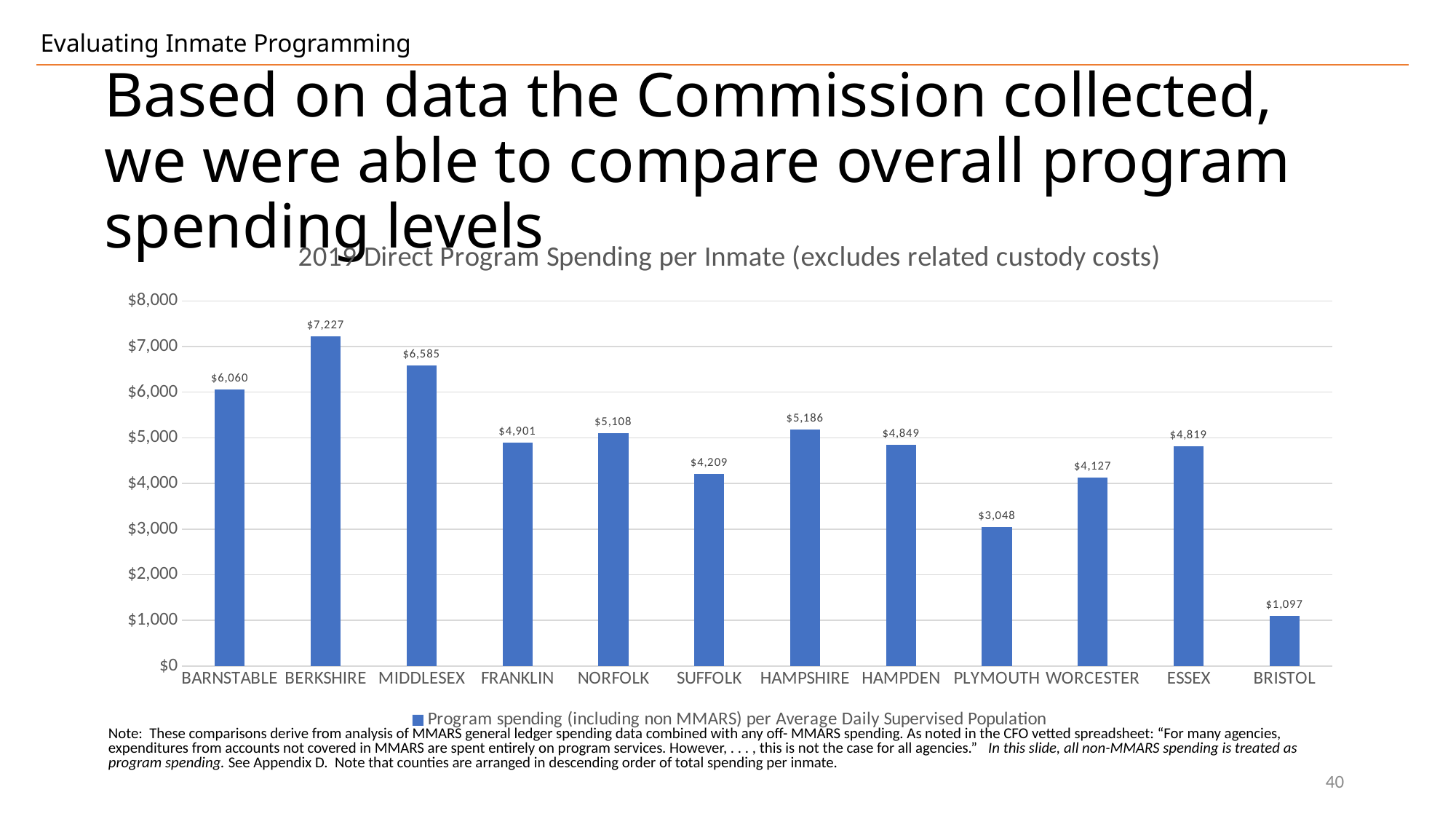
What is the difference between the values for Barnstable and Middlesex? $525 Which county has the lowest direct program spending per inmate? Bristol What is the value shown for Plymouth? $3,048 What kind of chart is shown on the slide? Bar chart What is the value shown for Bristol? $1,097 Is the value for Worcester greater or less than $4,000? greater What is the title of the chart? 2019 Direct Program Spending per Inmate (excludes related custody costs) Which is larger, the value for Norfolk or the value for Suffolk? Norfolk How many counties are shown on the x axis? 12 What is the 2019 direct program spending per inmate for Berkshire? $7,227 What is the difference between the values for Berkshire and Bristol? $6,130 Which county has the highest direct program spending per inmate? Berkshire